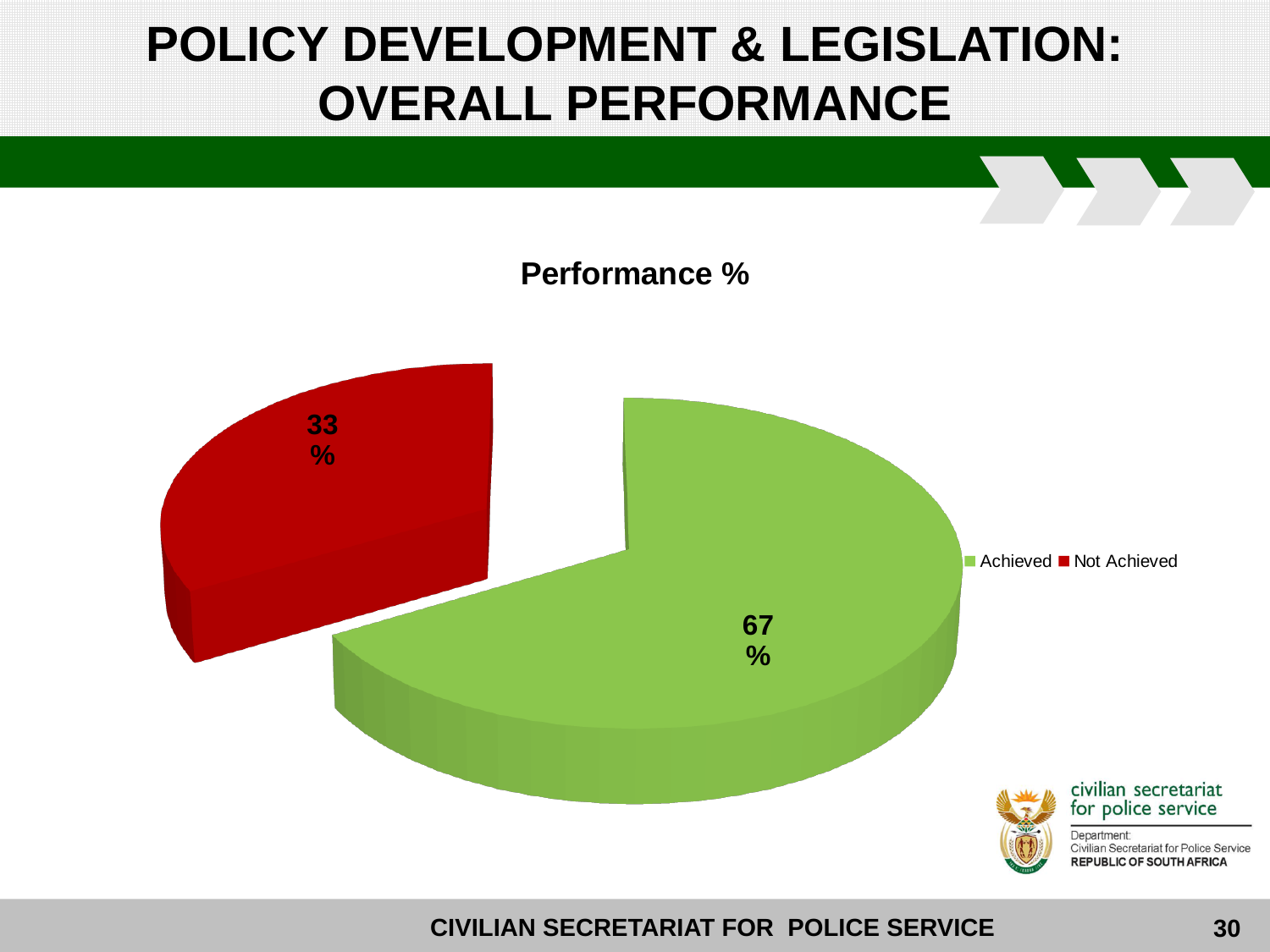
What percentage of the pie is labelled Not Achieved? 33% What is the chart's title? Performance % Which is larger, the Achieved slice or the Not Achieved slice? Achieved What is the difference in percentage points between the Achieved and Not Achieved slices? 34 How many slices does the pie chart have? 2 What type of chart is shown on the slide? Pie chart What percentage of the pie is labelled Achieved? 67% Which slice is the largest? Achieved What colour is the Not Achieved slice? Red What share of the pie does the Achieved slice represent? 67% Which slice is the smallest? Not Achieved How many entries does the legend list? 2